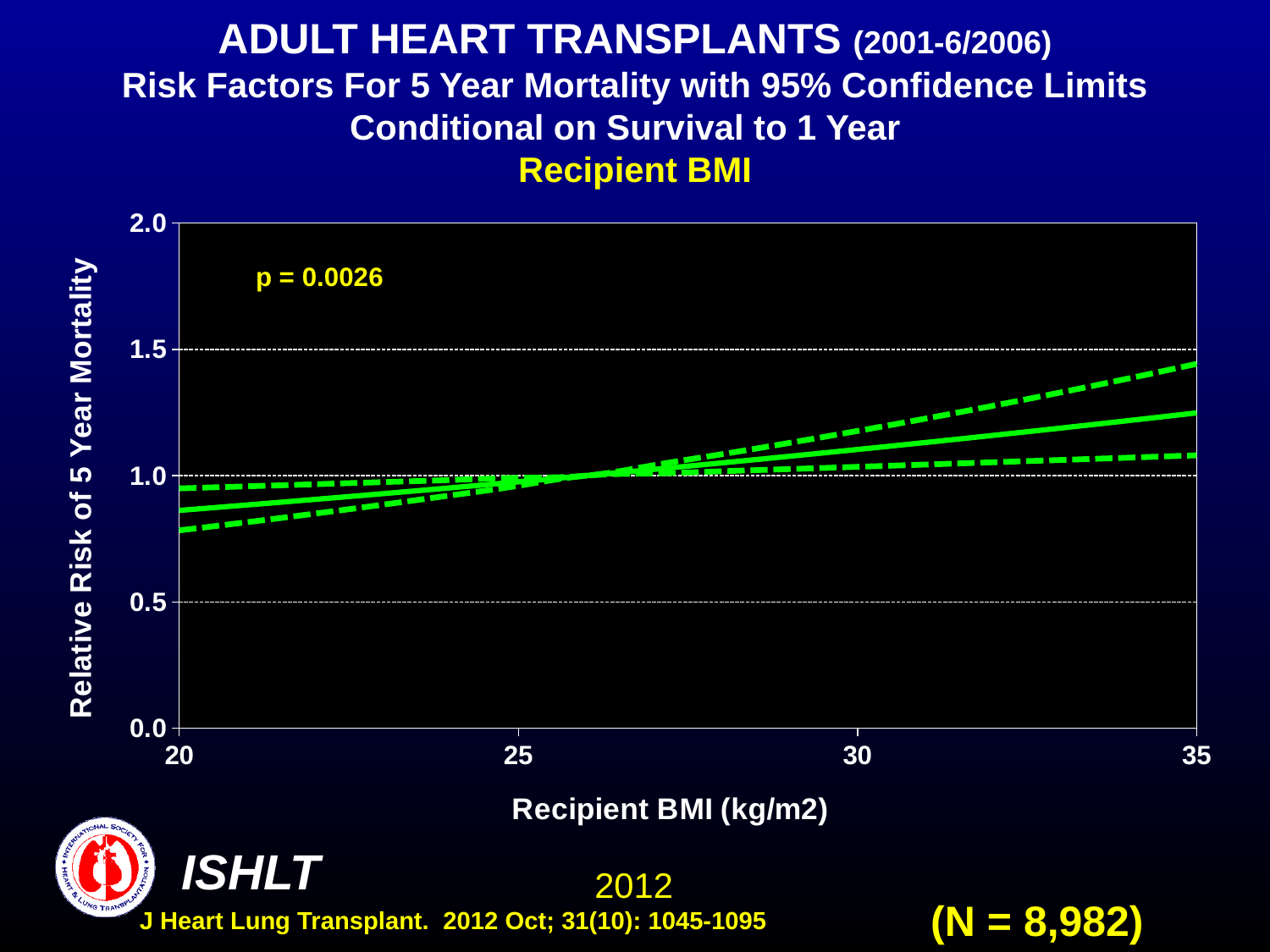
What is the highest value shown on the y axis? 2.0 Is the relative risk (solid line) at a recipient BMI of 35 greater or less than 1.0? greater What kind of chart is shown on the slide? line chart Is the upper 95% confidence limit at a recipient BMI of 35 greater or less than 1.0? greater What is the lowest recipient BMI value shown on the x axis? 20 What is the p-value shown on the chart? p = 0.0026 What is the sample size (N) shown on the slide? N = 8,982 Is the relative risk (solid line) at a recipient BMI of 35 greater or less than 1.5? less Does the relative risk of 5 year mortality rise or fall as recipient BMI increases from 20 to 35? rise How many lines are plotted on the chart? 3